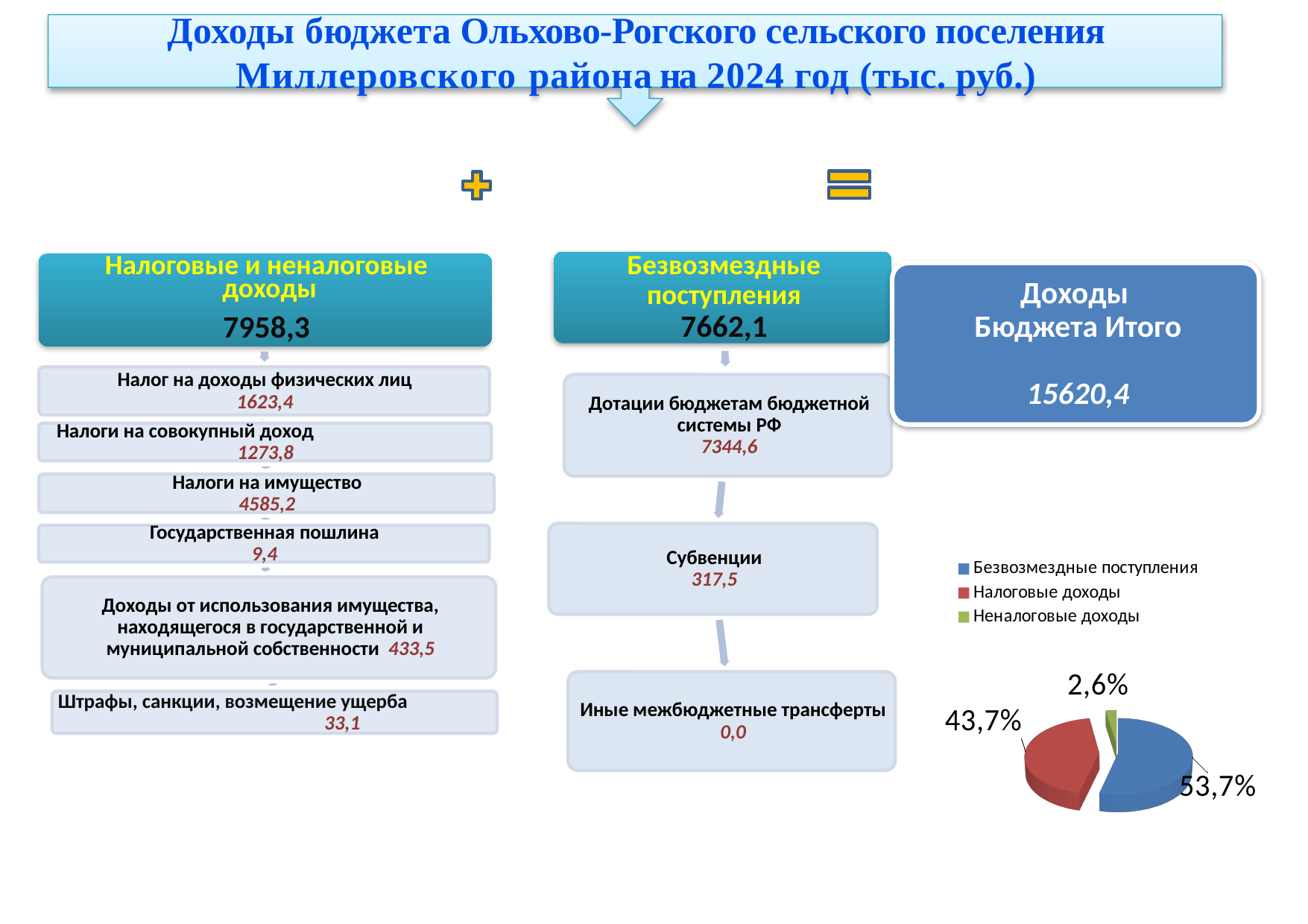
In the pie chart, what share is shown for Налоговые доходы? 43,7% In the pie chart, which is larger: Безвозмездные поступления or Налоговые доходы? Безвозмездные поступления In the pie chart, what share is shown for Неналоговые доходы? 2,6% In the pie chart, what share is shown for Безвозмездные поступления? 53,7% In the pie chart, what colour is the slice for Налоговые доходы? red Which slice of the pie chart is the largest? Безвозмездные поступления How many entries does the legend of the pie chart list? 3 What kind of chart is shown at the bottom right of the slide? pie chart How many slices does the pie chart have? 3 Which slice of the pie chart is the smallest? Неналоговые доходы In the pie chart, which legend entry is shown in green? Неналоговые доходы In the pie chart, what is the difference between the shares of Безвозмездные поступления and Налоговые доходы? 10,0%